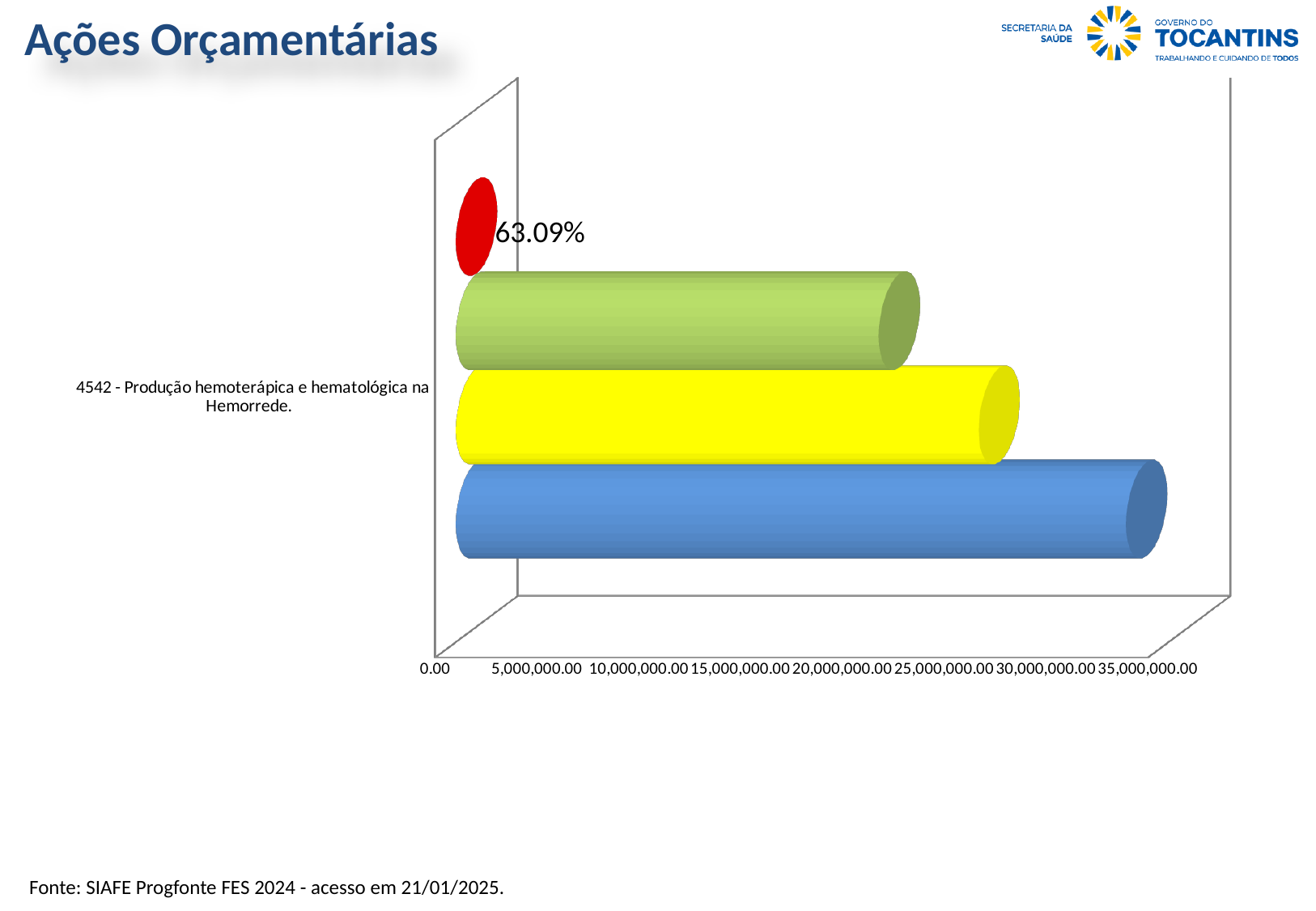
How many categories are shown on the vertical axis of the chart? 1 What is the category label shown on the chart? 4542 - Produção hemoterápica e hematológica na Hemorrede. What is the highest value shown on the horizontal axis of the chart? 35,000,000.00 Which coloured bar is the shortest in the chart? red Which is larger, the yellow bar or the green bar? yellow Is the value of the blue bar greater or less than 30,000,000.00? greater Is the value of the green bar greater or less than 25,000,000.00? less What value is printed as a data label on the red bar? 63.09% What kind of chart is shown on the slide? bar chart Which is larger, the blue bar or the yellow bar? blue Which coloured bar is the longest in the chart? blue